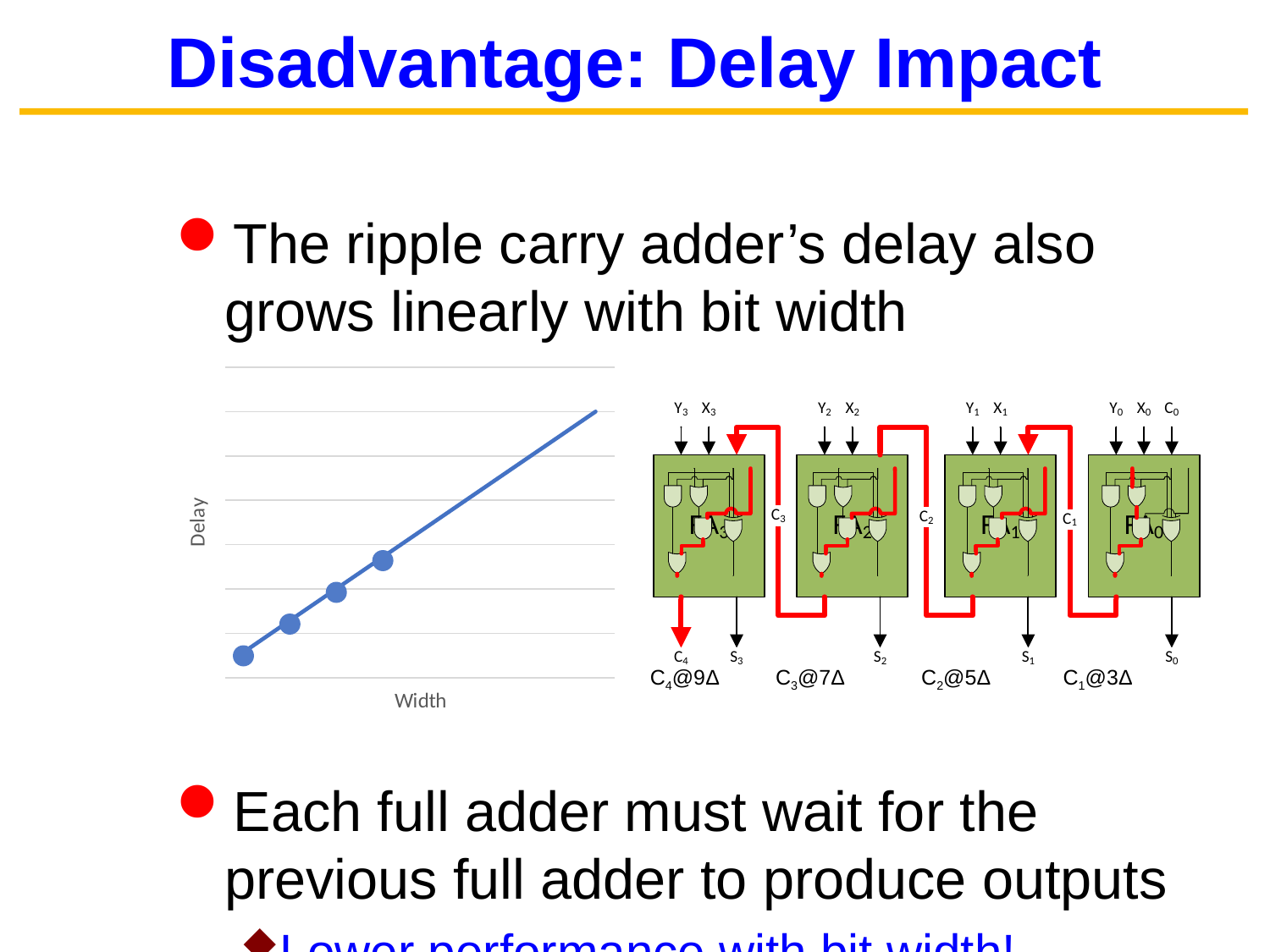
Is the trend of the plotted points on the chart increasing or decreasing? increasing Does the delay rise or fall as width increases along the x axis? rise What kind of chart is shown on the left of the slide? line chart What is the label on the chart's vertical axis? Delay What is the label on the chart's horizontal axis? Width